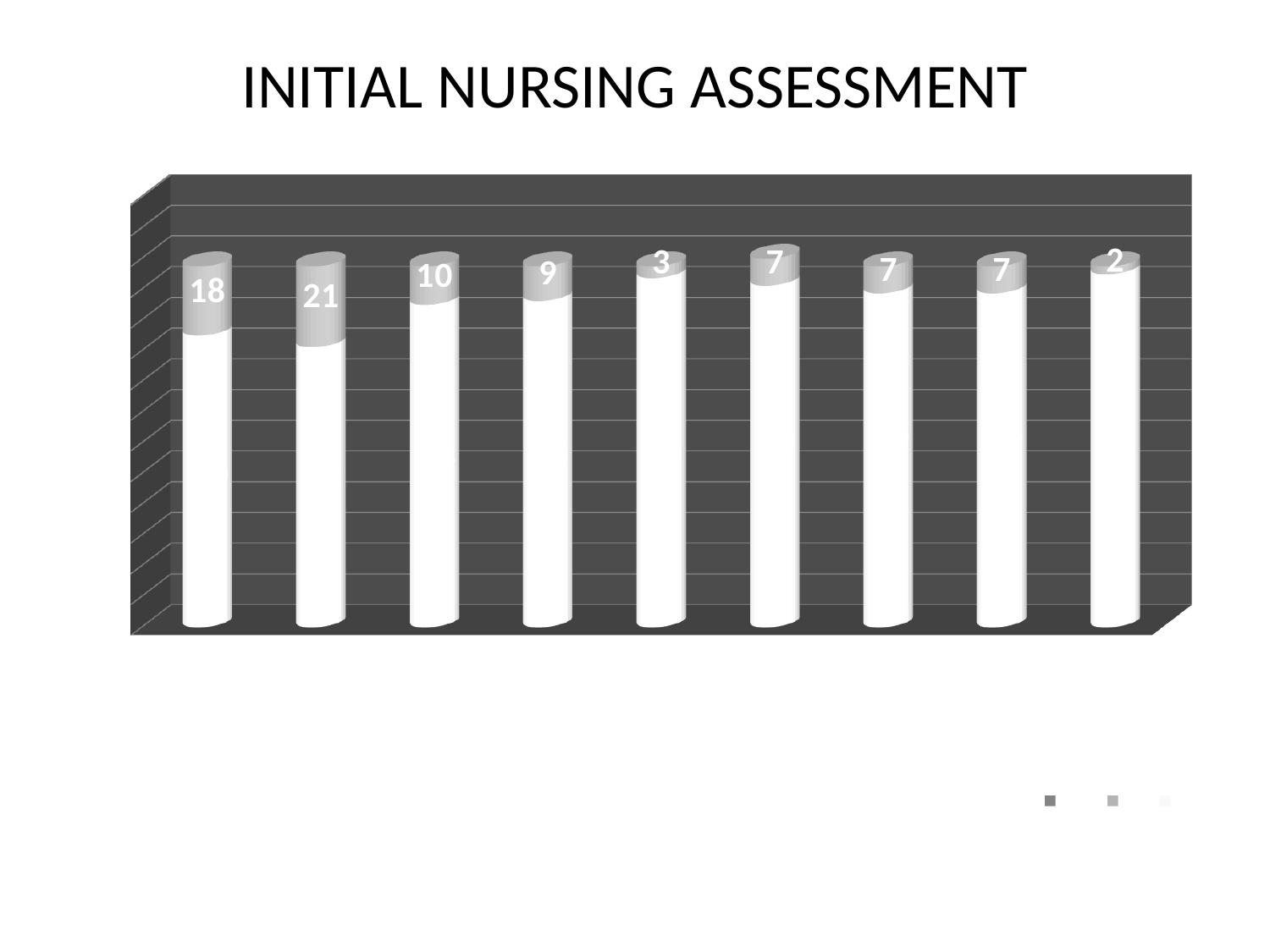
What is the value shown on the fifth bar from the left? 3 What is the title of the chart? INITIAL NURSING ASSESSMENT What is the lowest value labelled on any bar in the chart? 2 What is the difference between the value of the second bar from the left (21) and the leftmost bar (18)? 3 How many bars in the chart are labelled with the value 7? 3 What is the value shown on the leftmost bar? 18 How many bars are plotted in the chart? 9 What is the value shown on the second bar from the left? 21 What is the highest value labelled on any bar in the chart? 21 Which is larger, the value of the third bar from the left or the fourth bar from the left? the third bar (10) What is the value shown on the rightmost bar? 2 What kind of chart is shown on the slide? bar chart